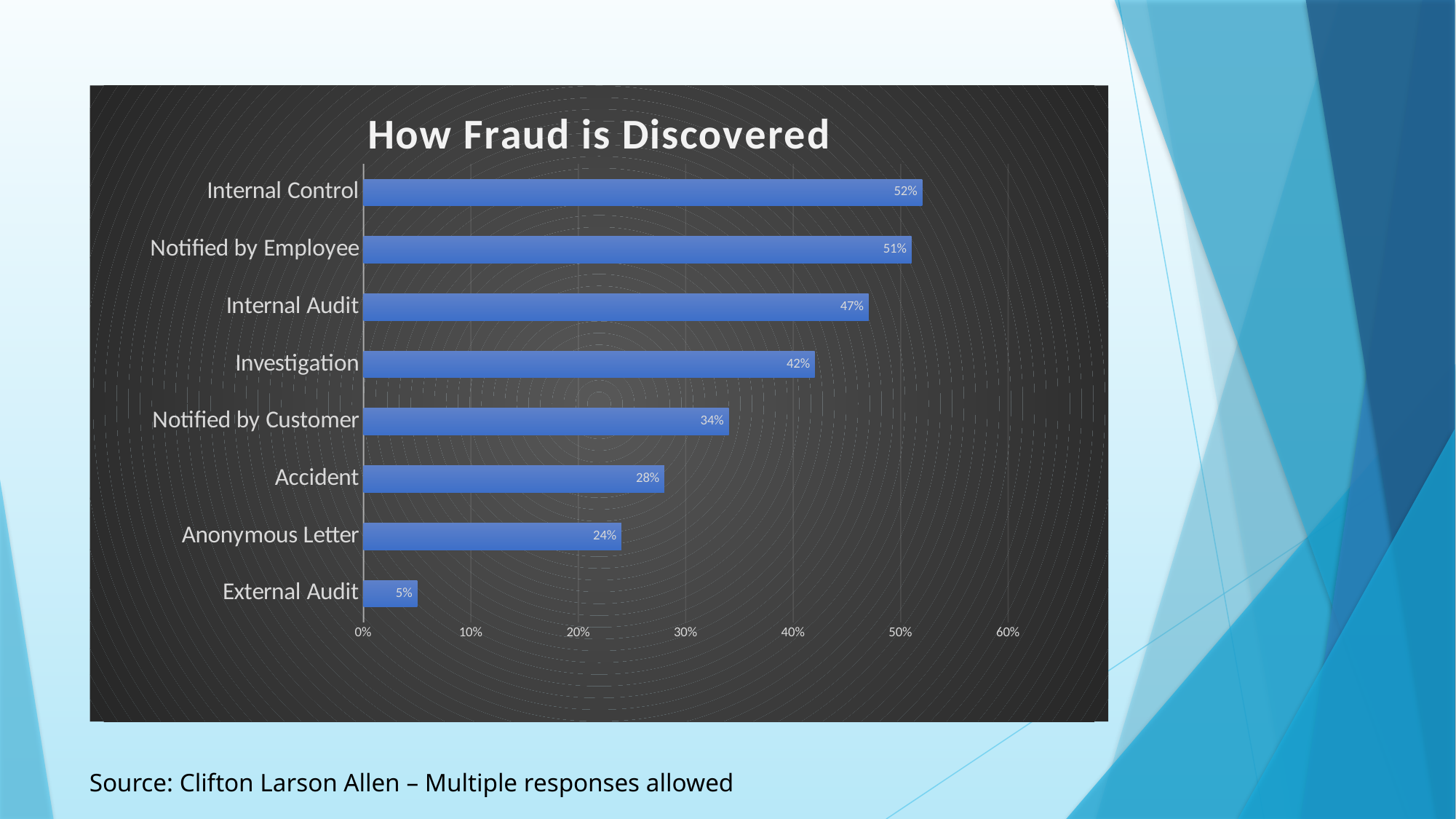
Which category has the highest value? Internal Control What is the difference between the values for Accident and Anonymous Letter? 4% What is the difference between the values for Internal Audit and Investigation? 5% What is the value for Notified by Customer? 34% Which is larger, the value for Investigation or the value for Notified by Customer? Investigation What is the value for Internal Control? 52% What is the title of the chart? How Fraud is Discovered What is the value for External Audit? 5% How many categories are shown in the chart? 8 Is the value for Notified by Employee greater or less than 40%? greater What kind of chart is shown on the slide? bar chart Which category has the lowest value? External Audit